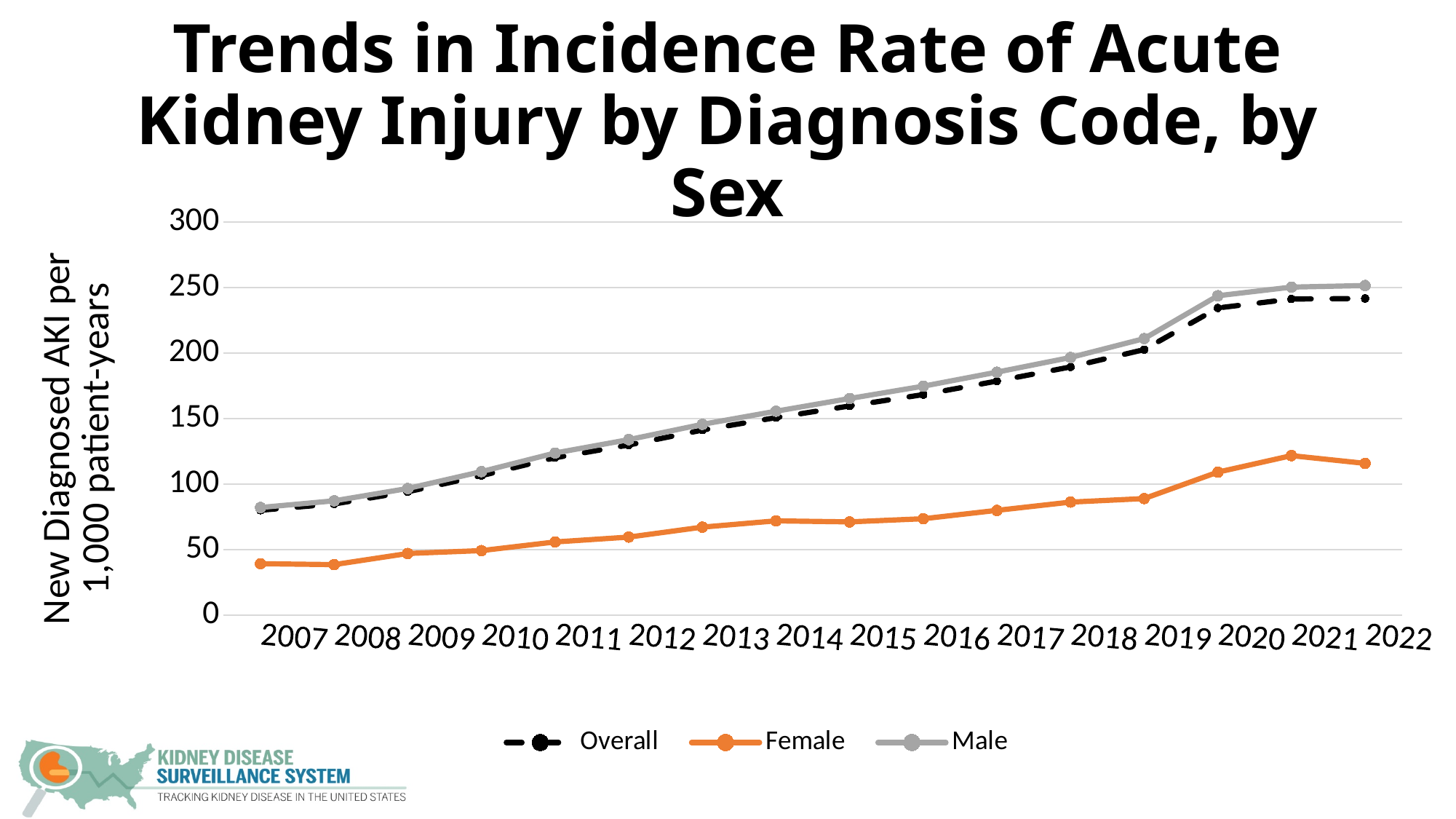
Is the value for Overall in 2019 greater or less than 150? greater In 2022, which is larger, the Male value or the Female value? Male In which year does the Female series reach its highest value? 2021 Does the Male series generally rise or fall from 2007 to 2022? rise Is the value for Male in 2022 greater or less than 200? greater How many years are plotted along the x axis? 16 What kind of chart is shown on the slide? line chart Is the value for Female in 2007 greater or less than 50? less How many series does the legend list? 3 What is the label on the y axis? New Diagnosed AKI per 1,000 patient-years